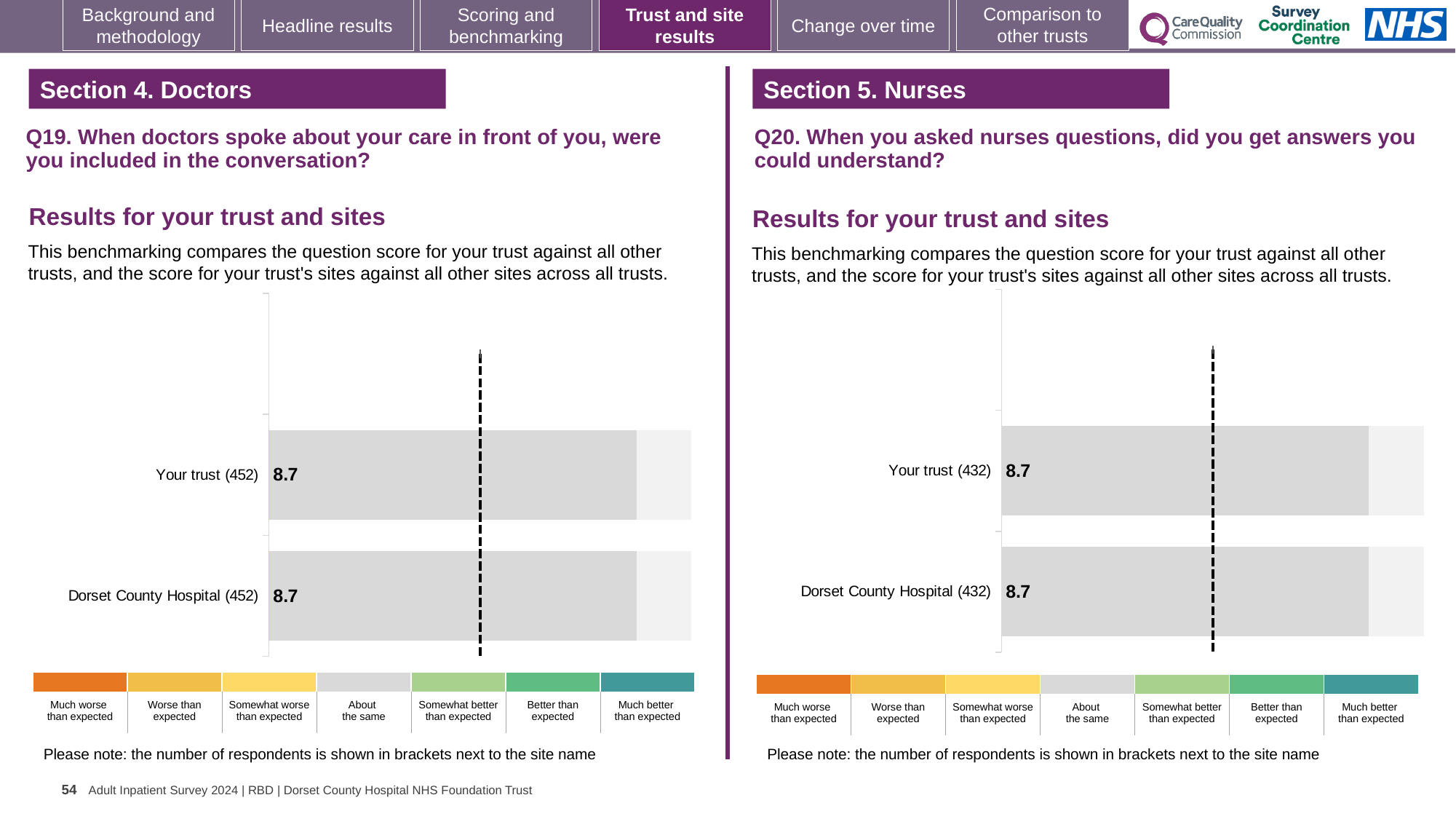
On the left chart (Q19, doctors), what is the difference between the score for Your trust and the score for Dorset County Hospital? 0 On the right chart (Q20, nurses), what is the difference between the score for Your trust and the score for Dorset County Hospital? 0 On the right chart (Q20, nurses), how many respondents are shown in brackets next to Dorset County Hospital? 432 What kind of chart is used on the left side of the slide for Q19? Bar chart On the left chart (Q19, doctors), what is the score for Your trust? 8.7 On the left chart (Q19, doctors), how many respondents are shown in brackets next to Your trust? 452 How many bars are plotted on the left chart (Q19, doctors)? 2 How many categories does the colour key below the left chart (Q19, doctors) list? 7 How many bars are plotted on the right chart (Q20, nurses)? 2 On the right chart (Q20, nurses), what is the score for Dorset County Hospital? 8.7 On the left chart (Q19, doctors), what is the score for Dorset County Hospital? 8.7 On the right chart (Q20, nurses), what is the score for Your trust? 8.7